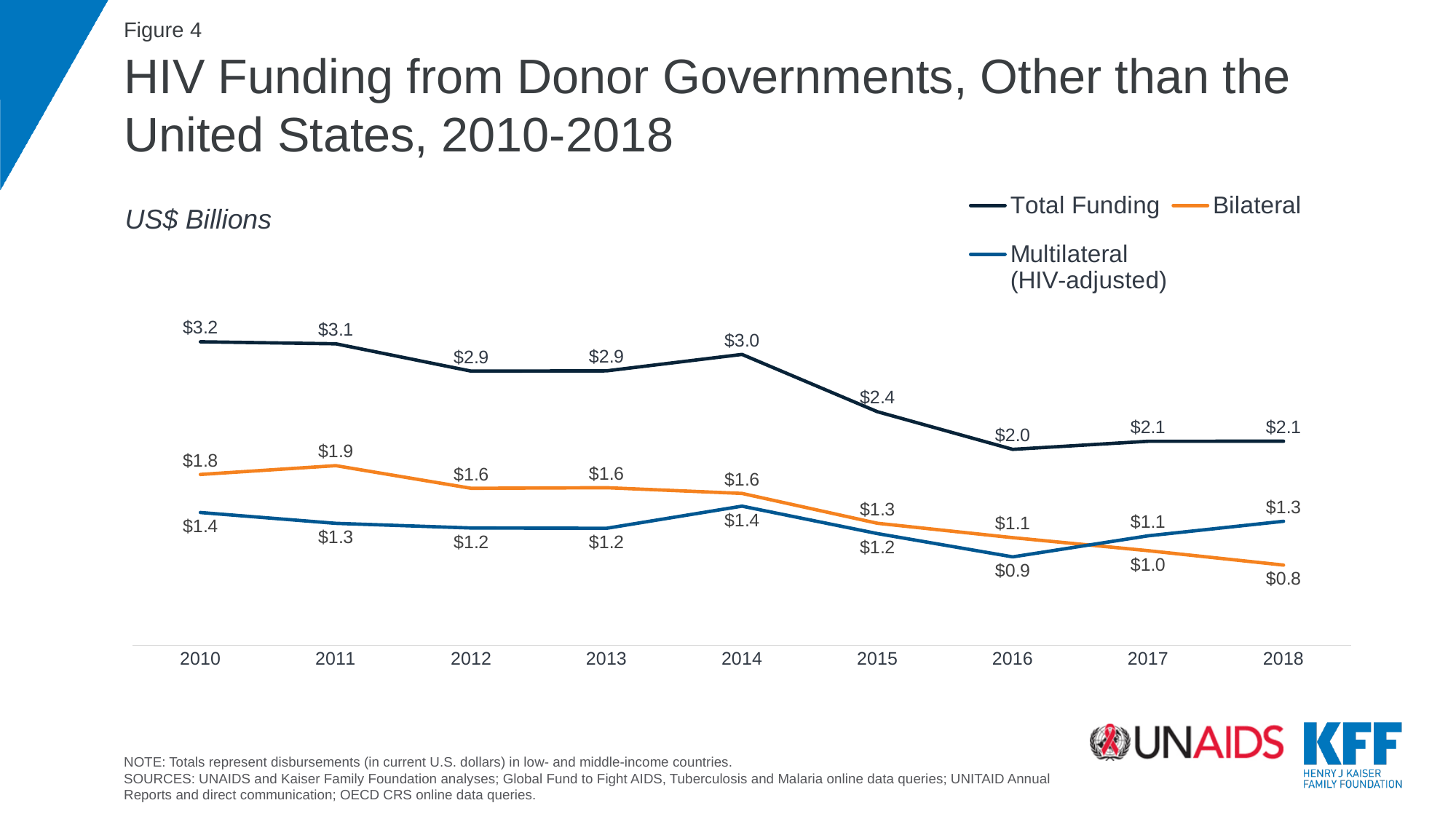
How many years are shown on the x axis? 9 What unit is the chart measured in? US$ Billions How many series does the legend list? 3 Did Bilateral funding rise or fall from 2011 to 2018? Fall In which year was Total Funding lowest? 2016 What is the difference between Total Funding in 2010 and in 2018? $1.1 Which was larger in 2018, Bilateral or Multilateral (HIV-adjusted)? Multilateral (HIV-adjusted) In which year was Bilateral funding highest? 2011 What kind of chart is this? Line chart What was Total Funding in 2010? $3.2 What was the Bilateral value in 2018? $0.8 What was the Multilateral (HIV-adjusted) value in 2016? $0.9